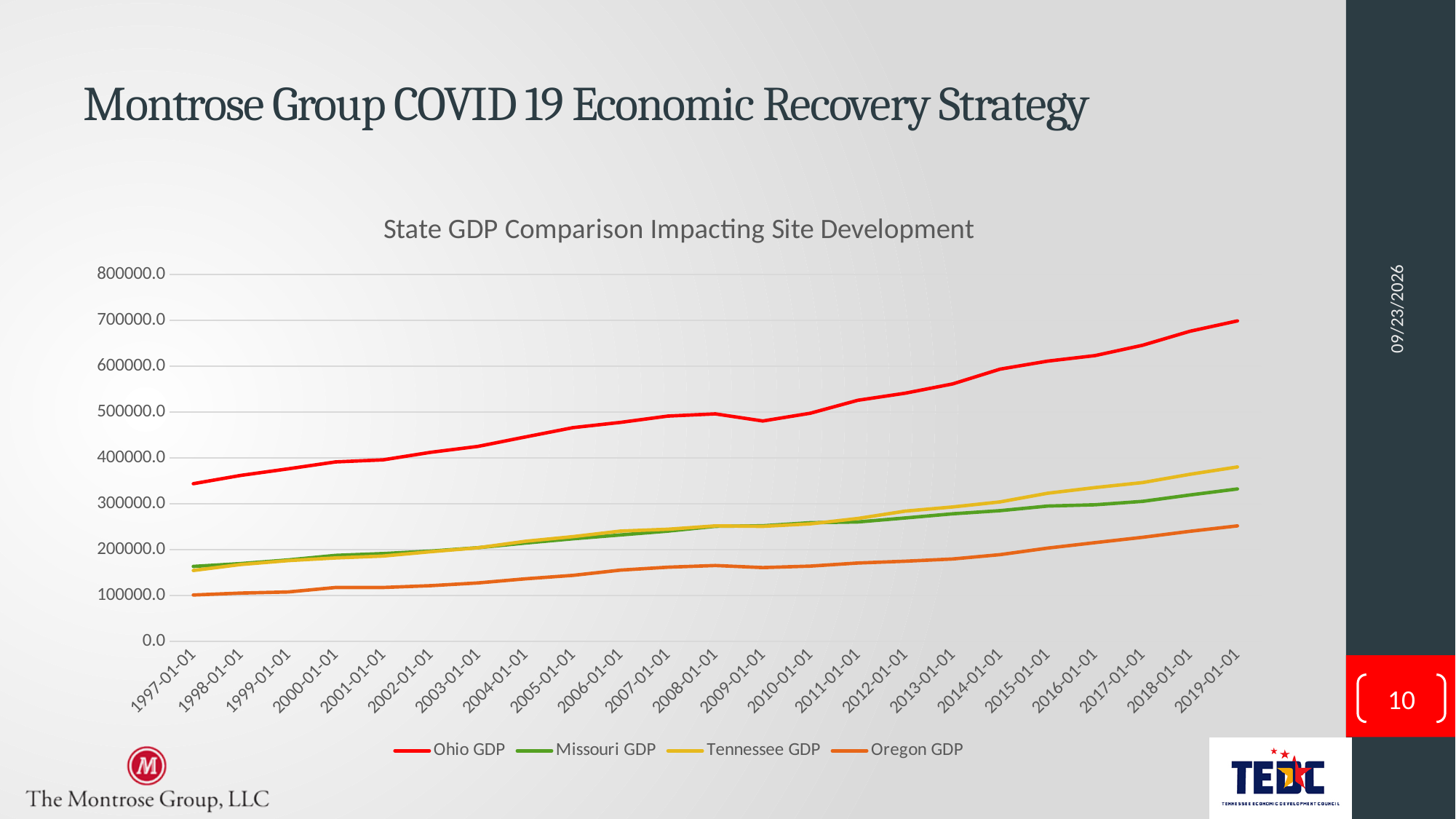
Is the value for Missouri GDP at 2019-01-01 greater or less than 300000.0? greater At 2019-01-01, which is larger: Tennessee GDP or Missouri GDP? Tennessee GDP What is the title of the chart? State GDP Comparison Impacting Site Development Is the value for Oregon GDP at 1997-01-01 greater or less than 200000.0? less Does Ohio GDP generally rise or fall from 1997-01-01 to 2019-01-01? rise Is the value for Oregon GDP at 2019-01-01 greater or less than 300000.0? less What kind of chart is shown on the slide? line chart How many dates are shown along the x axis? 23 Which series has the lowest values across the chart? Oregon GDP Which series has the highest values across the chart? Ohio GDP How many series does the legend list? 4